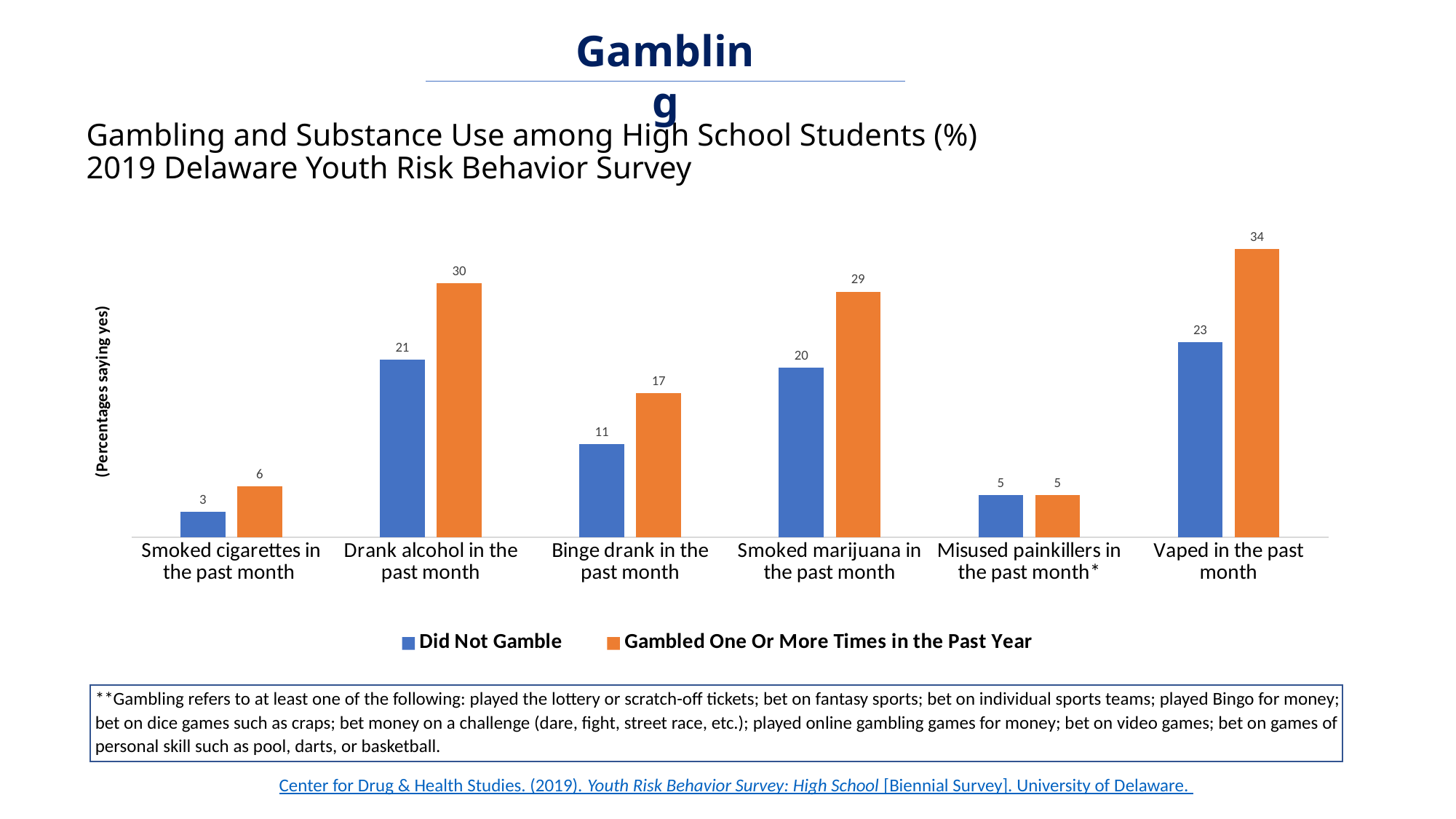
What percentage of students who gambled one or more times in the past year vaped in the past month? 34 What is the value for 'Drank alcohol in the past month' among students who gambled one or more times in the past year? 30 What is the difference between the 'Gambled One Or More Times in the Past Year' and 'Did Not Gamble' values for 'Smoked marijuana in the past month'? 9 For 'Binge drank in the past month', which series has the larger value: 'Did Not Gamble' or 'Gambled One Or More Times in the Past Year'? Gambled One Or More Times in the Past Year What percentage of students who did not gamble smoked cigarettes in the past month? 3 For which category are the 'Did Not Gamble' and 'Gambled One Or More Times in the Past Year' values equal? Misused painkillers in the past month* What kind of chart is shown on the slide? Bar chart Which category has the lowest value for the 'Did Not Gamble' series? Smoked cigarettes in the past month How many series does the legend list? 2 How many categories are shown on the x axis of the chart? 6 Which category has the highest value for the 'Gambled One Or More Times in the Past Year' series? Vaped in the past month What colour represents the 'Did Not Gamble' series in the chart? Blue